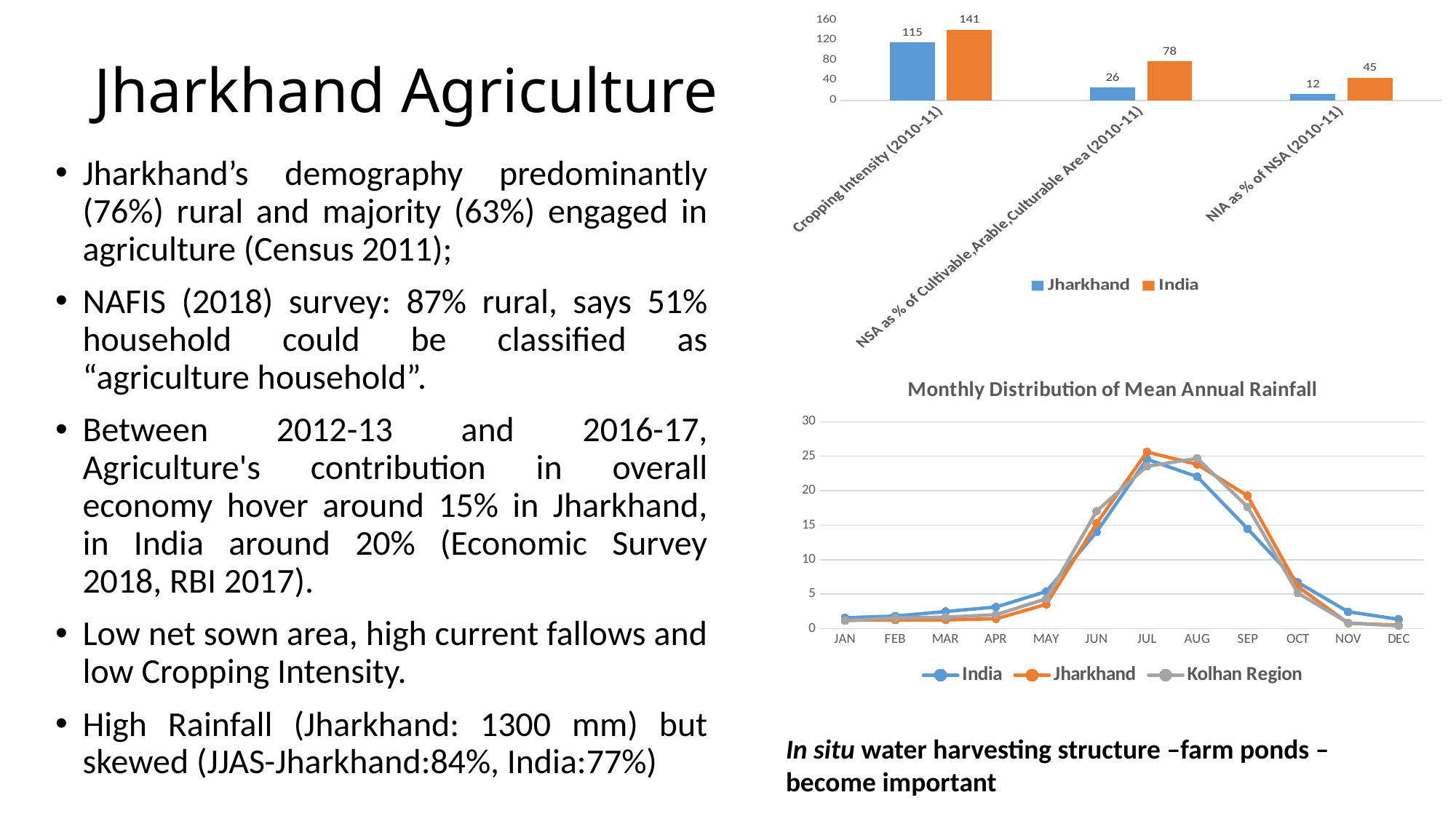
In the top bar chart, what is the value for Jharkhand for Cropping Intensity (2010-11)? 115 In the top bar chart, which is larger for NIA as % of NSA (2010-11): Jharkhand or India? India In the 'Monthly Distribution of Mean Annual Rainfall' chart, how many months are shown on the x axis? 12 In the 'Monthly Distribution of Mean Annual Rainfall' chart, in which month does the Jharkhand series reach its highest value? JUL In the 'Monthly Distribution of Mean Annual Rainfall' chart, do the values fall or rise from JUL to DEC? Fall In the top bar chart, which category has the lowest value for Jharkhand? NIA as % of NSA (2010-11) In the top bar chart, what is the difference between India and Jharkhand for Cropping Intensity (2010-11)? 26 What type of chart is the 'Monthly Distribution of Mean Annual Rainfall' chart? Line chart In the 'Monthly Distribution of Mean Annual Rainfall' chart, is the value for India in AUG greater or less than 20? greater In the top bar chart, what is the value for India for NSA as % of Cultivable, Arable, Culturable Area (2010-11)? 78 How many series does the legend of the top bar chart list? 2 In the top bar chart, what is the value for India for NIA as % of NSA (2010-11)? 45